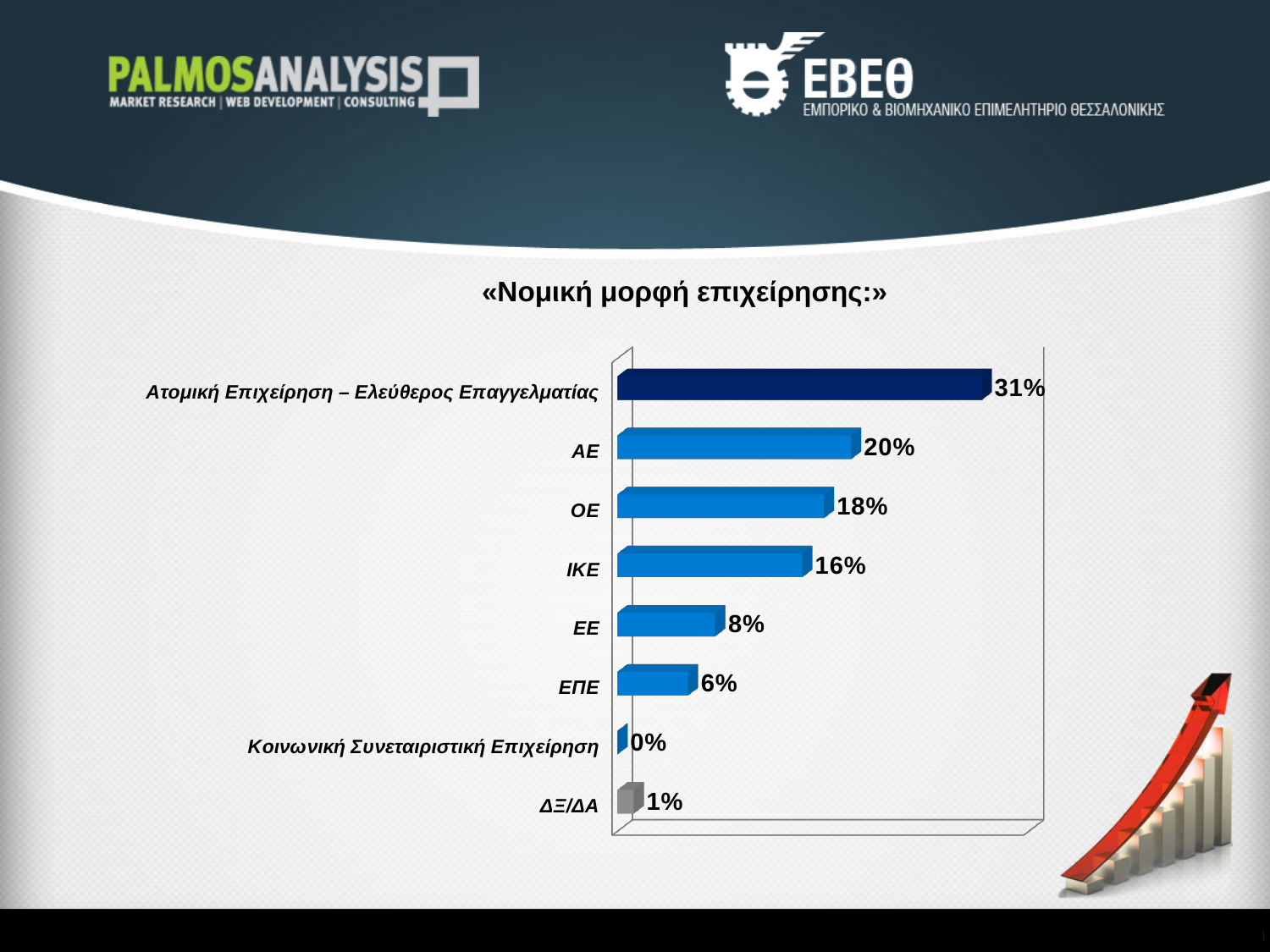
Which category has the highest value? Ατομική Επιχείρηση – Ελεύθερος Επαγγελματίας What is the difference between the values for ΟΕ and ΙΚΕ? 2% What kind of chart is shown on the slide? bar chart What is the value for ΑΕ? 20% What is the value for ΕΠΕ? 6% What is the value for Ατομική Επιχείρηση – Ελεύθερος Επαγγελματίας? 31% Which category has the lowest value? Κοινωνική Συνεταιριστική Επιχείρηση Which is larger, the value for ΟΕ or the value for ΕΠΕ? ΟΕ How many categories are shown in the chart? 8 What is the title of the chart? «Νομική μορφή επιχείρησης:» What is the difference between the values for ΑΕ and ΕΕ? 12% What is the value for Κοινωνική Συνεταιριστική Επιχείρηση? 0%